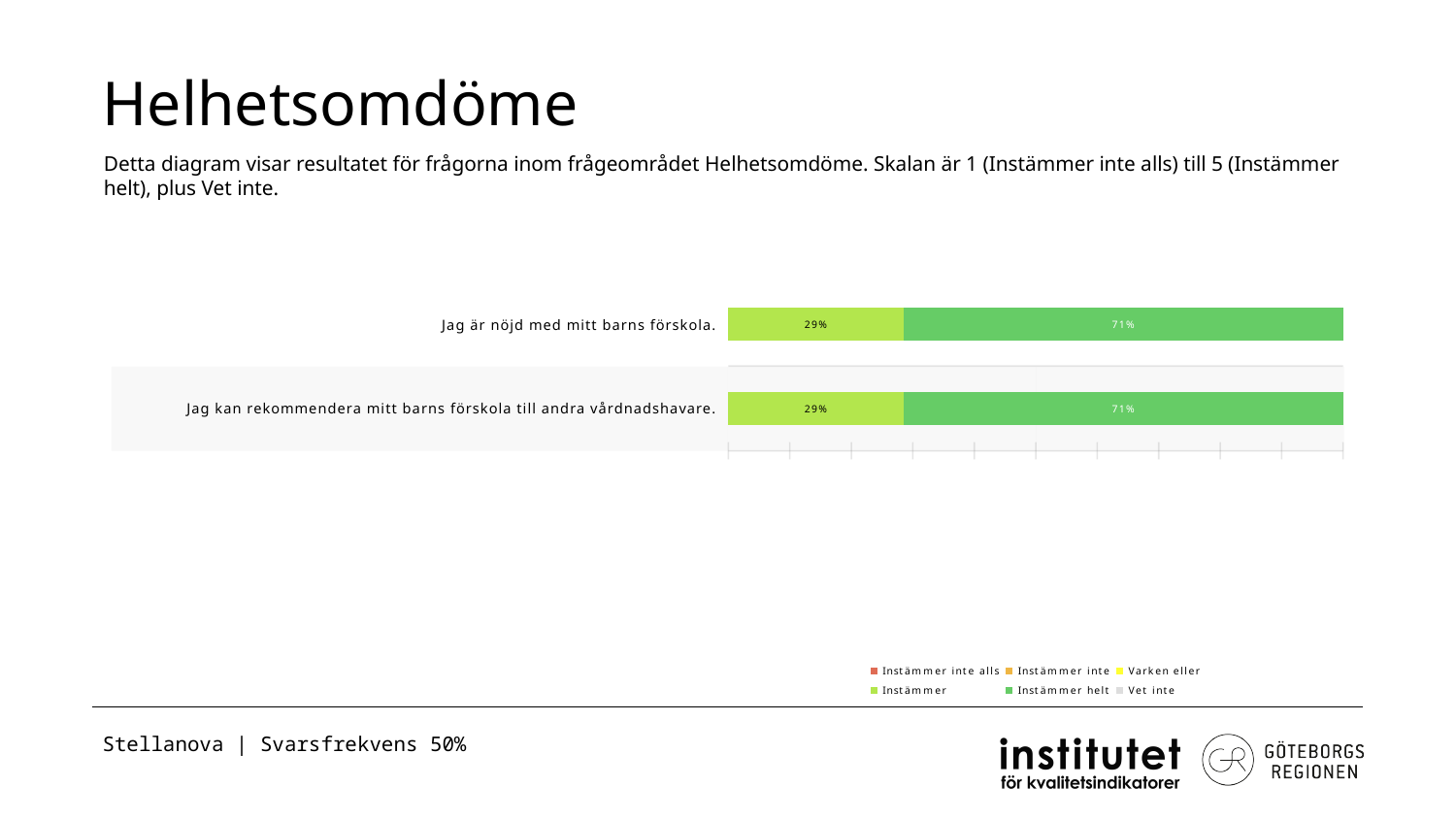
How many series does the legend list? 6 What is the difference between "Instämmer helt" and "Instämmer" for "Jag kan rekommendera mitt barns förskola till andra vårdnadshavare."? 42% For "Jag är nöjd med mitt barns förskola.", which is larger: "Instämmer" or "Instämmer helt"? Instämmer helt What is the total of the stacked bar for "Jag är nöjd med mitt barns förskola."? 100% What is the value of "Instämmer" for "Jag kan rekommendera mitt barns förskola till andra vårdnadshavare."? 29% Which legend entry is listed first in the legend? Instämmer inte alls How many categories (statements) are plotted in the chart? 2 Which legend entry is shown in the darker green colour? Instämmer helt What kind of chart is shown on the slide? bar chart What is the value of "Instämmer helt" for "Jag kan rekommendera mitt barns förskola till andra vårdnadshavare."? 71% What is the value of "Instämmer" for "Jag är nöjd med mitt barns förskola."? 29% What is the value of "Instämmer helt" for "Jag är nöjd med mitt barns förskola."? 71%